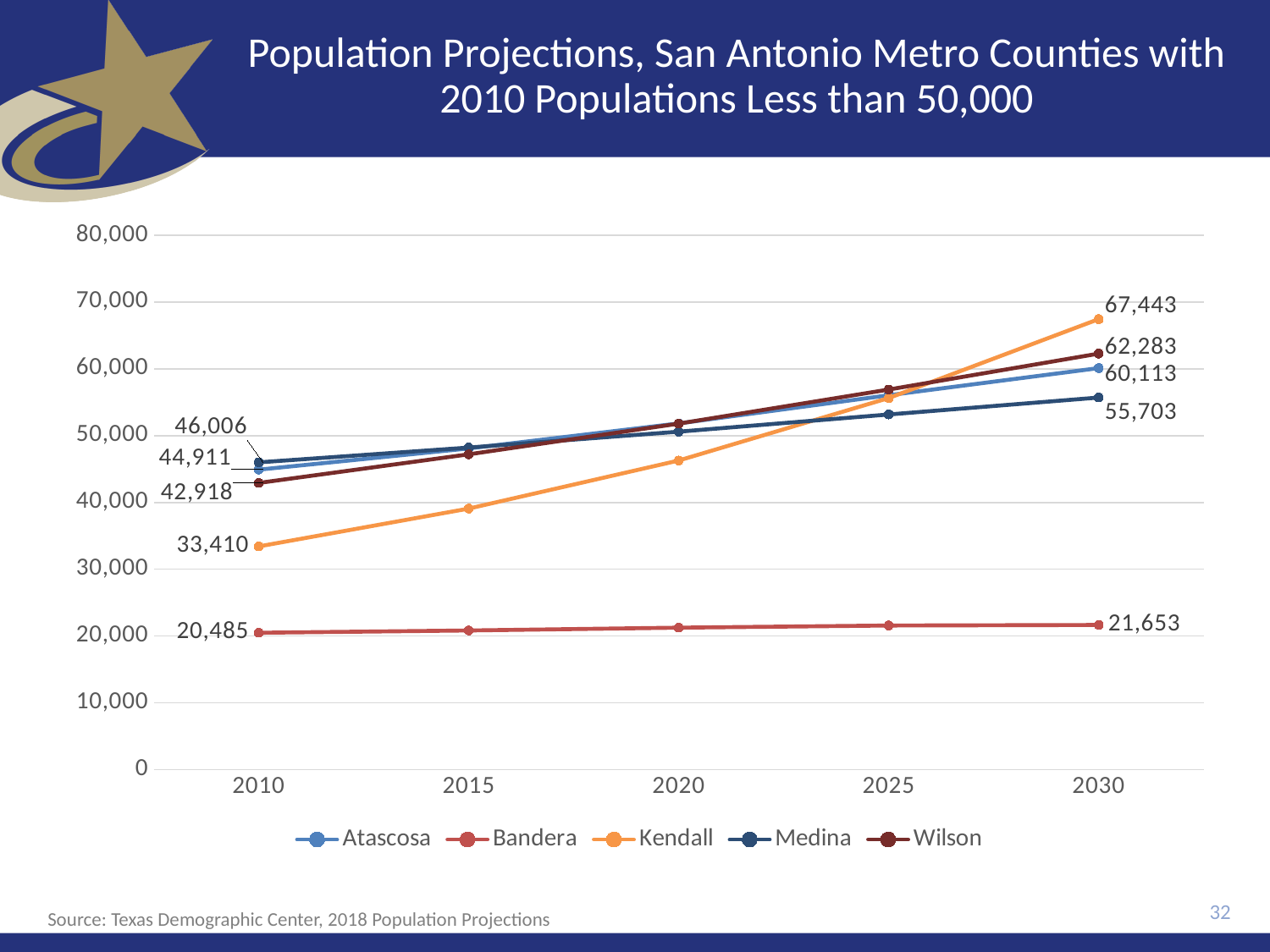
Does the Kendall County line rise or fall from 2010 to 2030? rises How many years are shown on the x axis? 5 Which county has the highest projected population in 2030? Kendall What is the projected population of Medina County in 2030? 55,703 Which county has the lowest projected population in 2030? Bandera Which county has the larger projected population in 2030, Wilson or Atascosa? Wilson By how much is Kendall County's population projected to grow from 2010 to 2030? 34,033 What kind of chart is shown on the slide? line chart Is the projected population of Kendall County in 2020 greater or less than 50,000? less What is the projected population of Kendall County in 2030? 67,443 How many counties does the legend list? 5 What is the population of Bandera County in 2010? 20,485